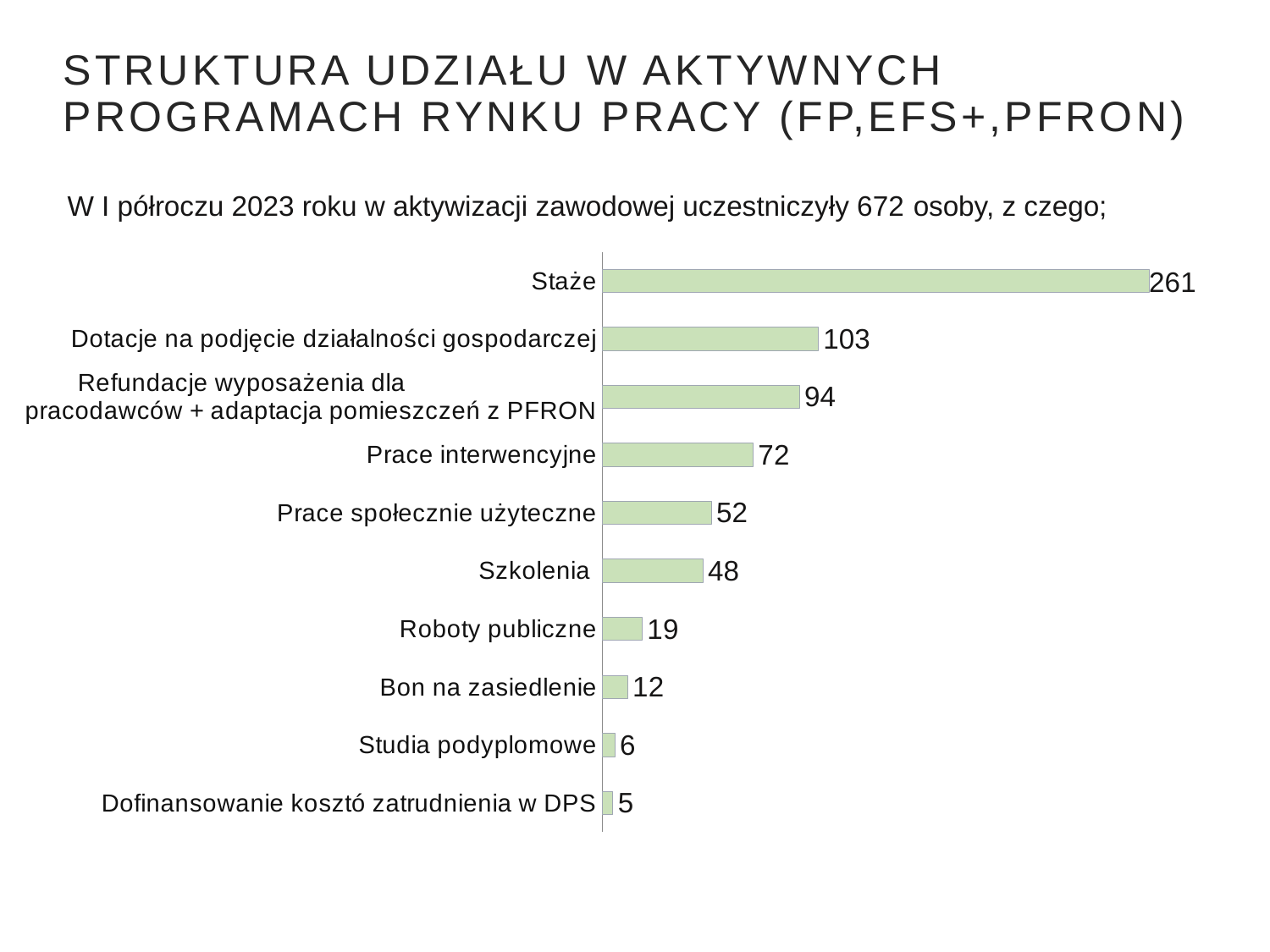
What is the difference between the values for Staże and Dotacje na podjęcie działalności gospodarczej? 158 What is the value for Staże? 261 What is the value for Szkolenia? 48 Which category has the lowest value? Dofinansowanie kosztó zatrudnienia w DPS What is the value for Bon na zasiedlenie? 12 What kind of chart is shown on the slide? Bar chart How many categories are shown in the chart? 10 What is the difference between the values for Prace społecznie użyteczne and Szkolenia? 4 What is the value for Prace interwencyjne? 72 Which category has the highest value? Staże Which is larger, the value for Roboty publiczne or the value for Studia podyplomowe? Roboty publiczne What is the value for Dotacje na podjęcie działalności gospodarczej? 103